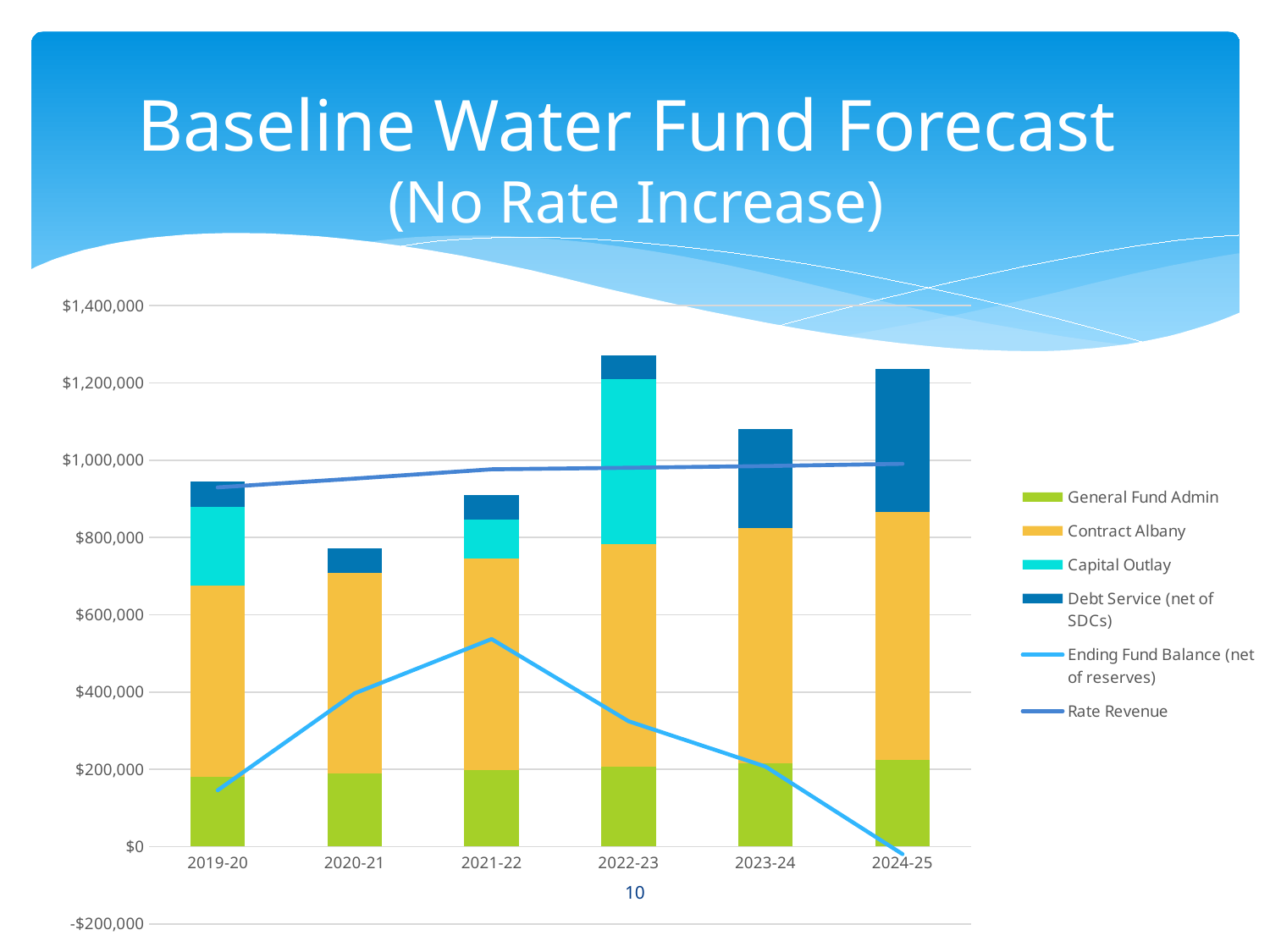
Which is larger, the Debt Service (net of SDCs) segment in 2024-25 or in 2019-20? 2024-25 In which fiscal year does the Ending Fund Balance (net of reserves) line reach its highest point? 2021-22 Is the Rate Revenue value for 2019-20 greater or less than $1,000,000? less Which fiscal year has the lowest total stacked bar? 2020-21 In which fiscal year is the Ending Fund Balance (net of reserves) line at its lowest? 2024-25 Is the Ending Fund Balance (net of reserves) for 2021-22 greater or less than $400,000? greater How does the Ending Fund Balance (net of reserves) line move from 2021-22 to 2024-25? It falls Is the total stacked bar for 2020-21 greater or less than $800,000? less How many series does the legend list? 6 How many fiscal years are shown on the x axis? 6 What kind of chart is shown on the slide? Stacked bar chart with line series